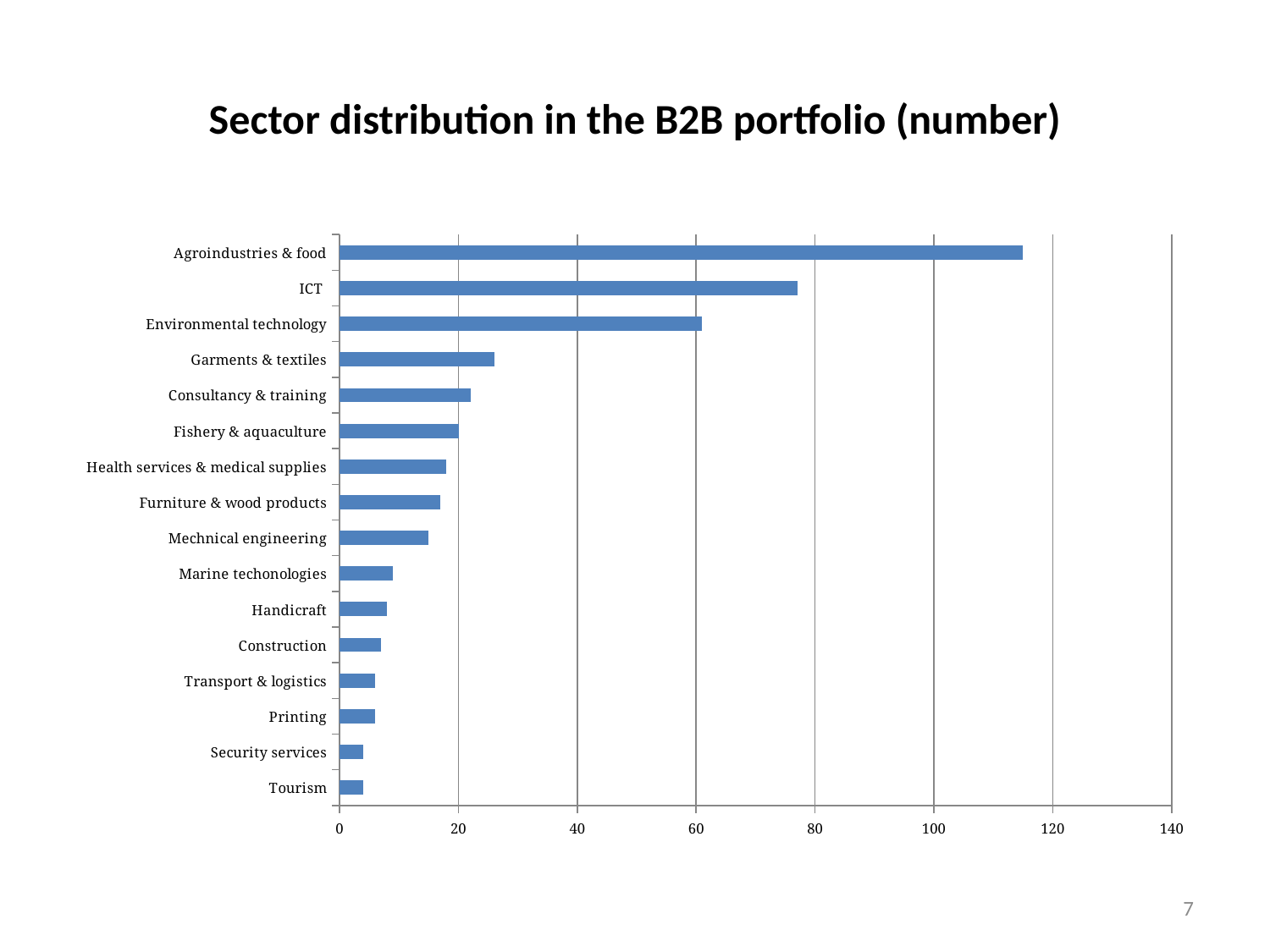
How many sectors are plotted in the chart? 16 Is the value for Garments & textiles greater or less than 20? greater Which sector has the highest value? Agroindustries & food Which is larger, the value for Garments & textiles or the value for Consultancy & training? Garments & textiles Is the value for ICT greater or less than 80? less Is the value for Environmental technology greater or less than 40? greater What is the highest value shown on the horizontal axis? 140 What kind of chart is shown on the slide? bar chart Which is larger, the value for ICT or the value for Environmental technology? ICT What is the title of the chart? Sector distribution in the B2B portfolio (number)